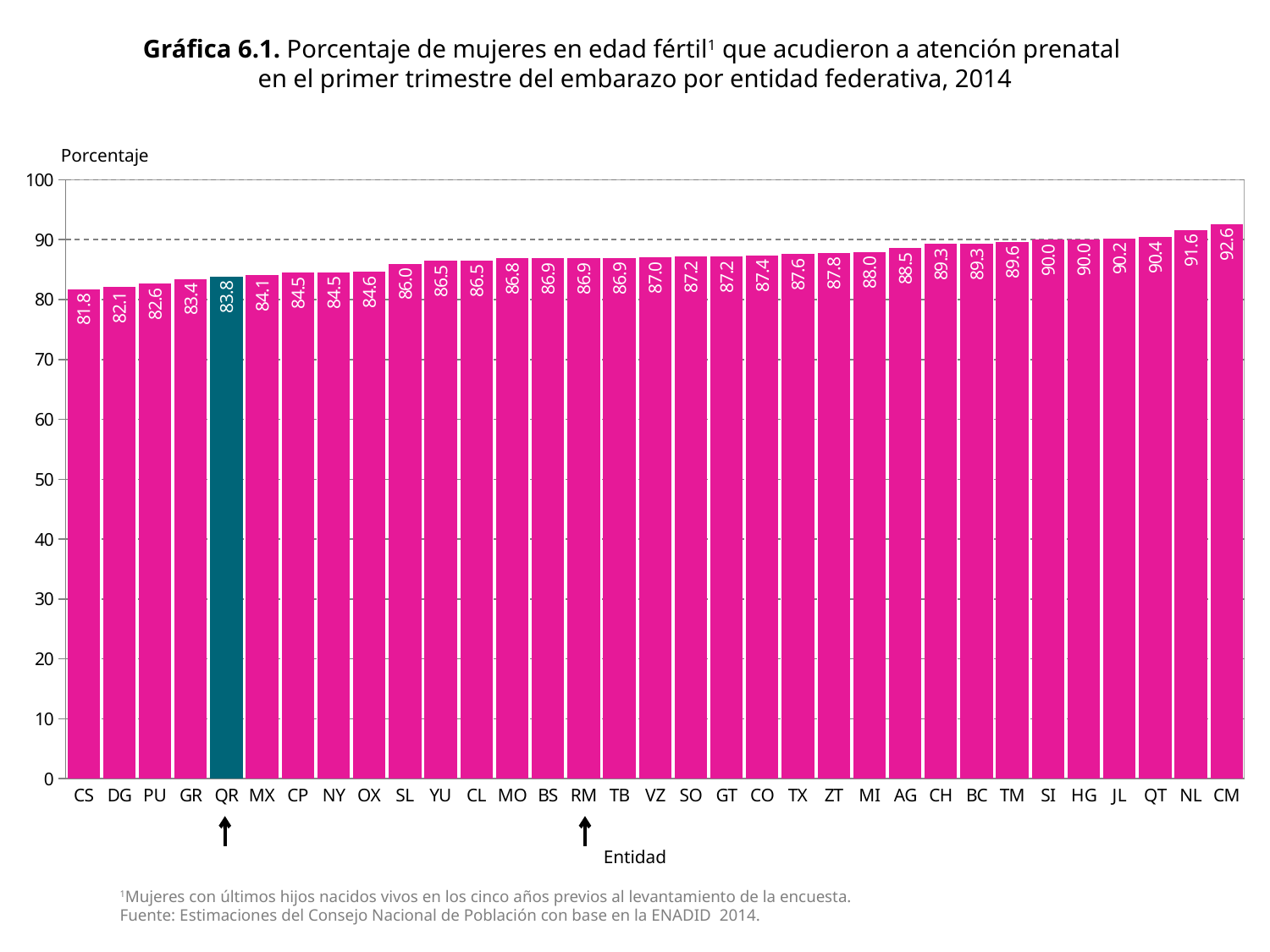
Do the values rise or fall from left to right along the x axis? rise How many bars are shown in the chart? 33 What is the value for NL? 91.6 What is the value for RM? 86.9 What type of chart is shown on the slide? bar chart Is the value for QT greater or less than 90? greater What is the difference between the values for CM and CS? 10.8 Which entity has the lowest value? CS Which entity has the highest value? CM What is the value for QR? 83.8 Which has a larger value, MI or SL? MI What is the value for CS? 81.8